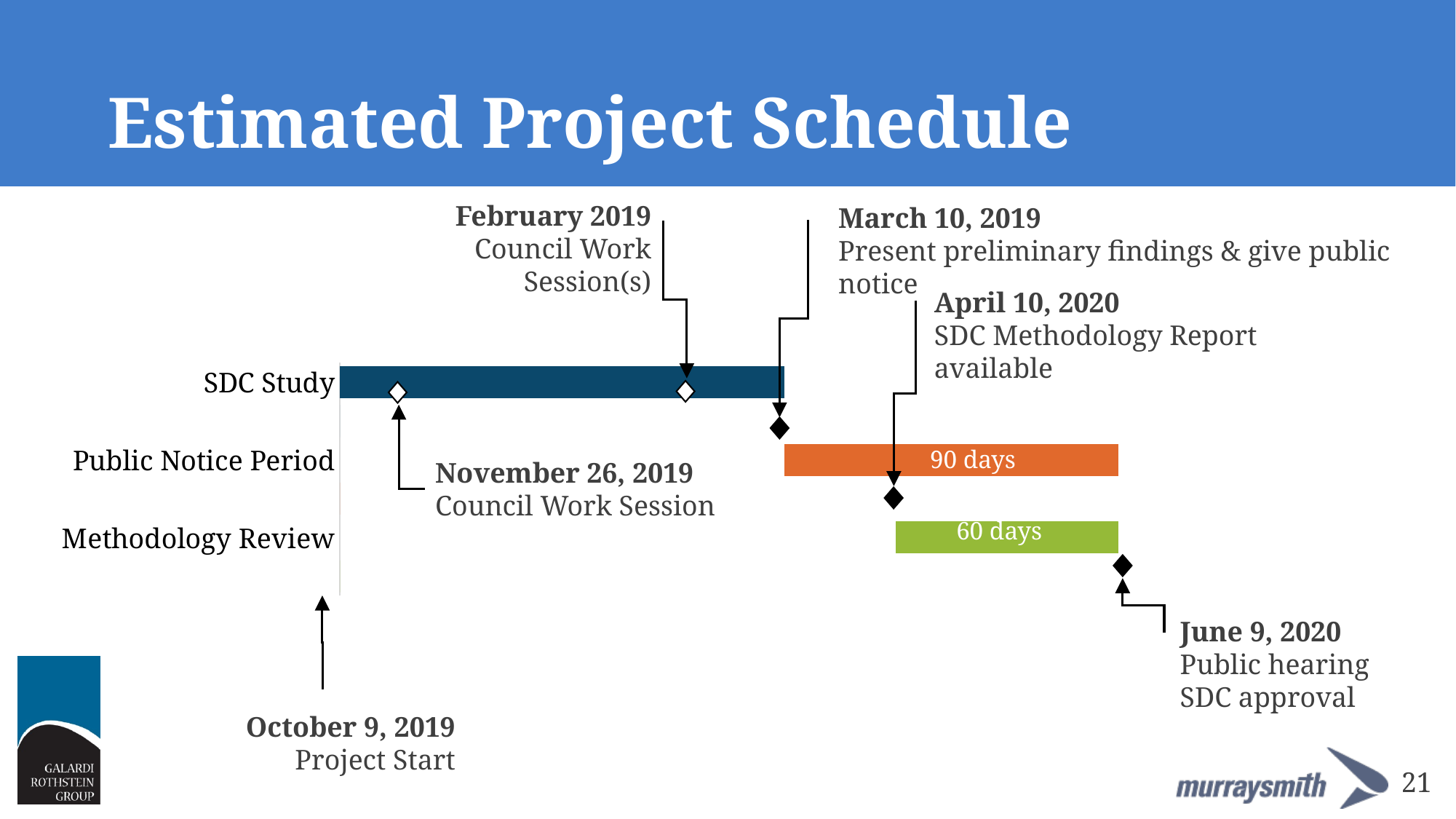
Which is longer, the Public Notice Period or the Methodology Review? Public Notice Period What date is labelled as the Project Start? October 9, 2019 What is the duration label printed on the Methodology Review bar? 60 days What colour is the Public Notice Period bar? orange What is the duration label printed on the Public Notice Period bar? 90 days How many task categories are listed on the vertical axis of the chart? 3 What kind of chart is shown on the slide? bar chart (Gantt chart) How many days longer is the Public Notice Period than the Methodology Review? 30 days What is the title of the slide containing the chart? Estimated Project Schedule Which task bar is the shortest in the chart? Methodology Review What event is scheduled for June 9, 2020? Public hearing SDC approval Which task bar is the longest in the chart? SDC Study